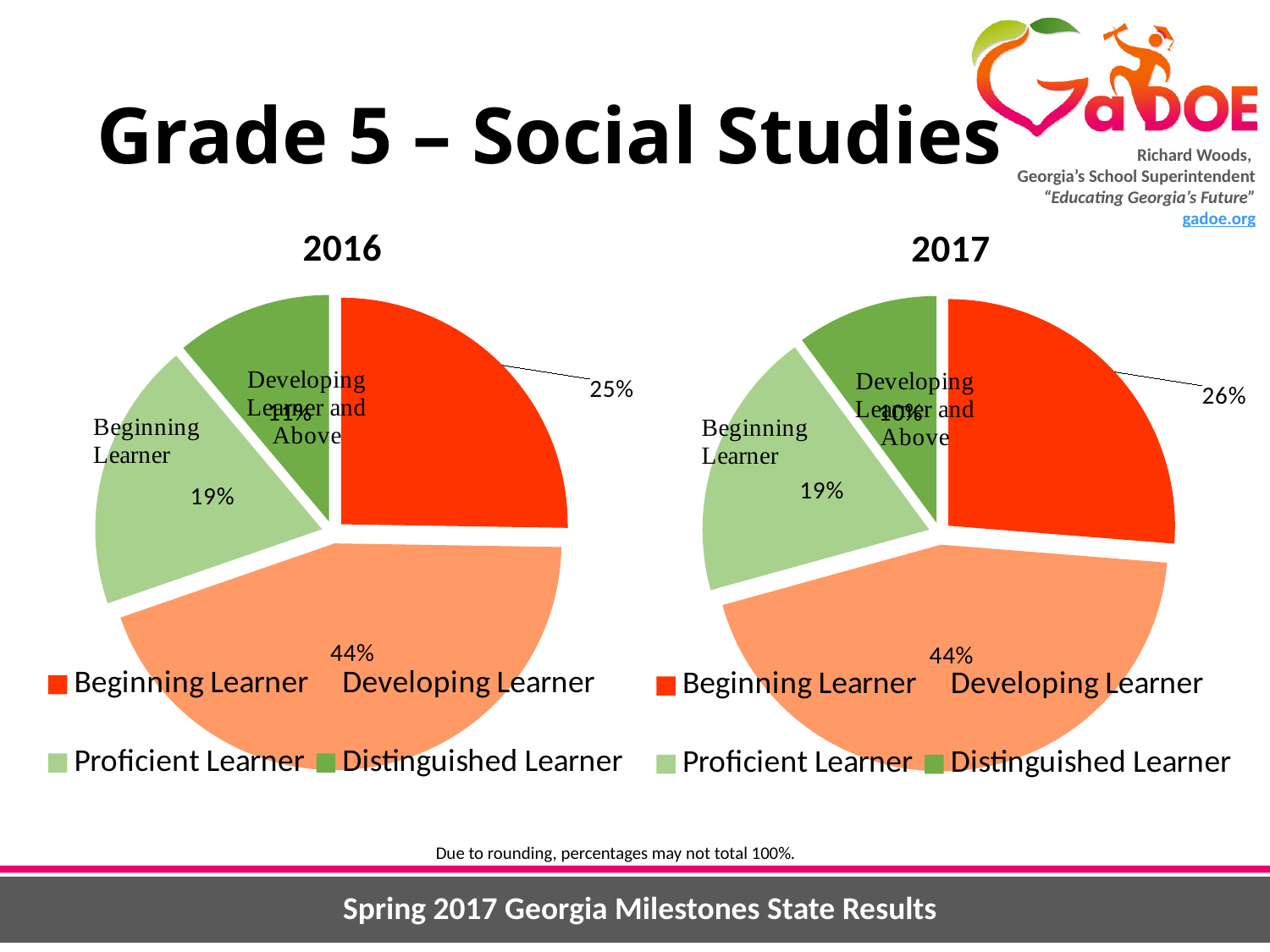
In the 2016 pie chart, what percentage is shown for Developing Learner? 44% In the 2017 pie chart, what percentage is shown for Beginning Learner? 26% How many slices does the 2017 pie chart have? 4 By how many percentage points did the Beginning Learner share change from the 2016 chart to the 2017 chart? 1 percentage point How many entries does the legend of the 2016 chart list? 4 In the 2016 pie chart, what percentage is shown for Beginning Learner? 25% In the 2016 pie chart, which category has the largest slice? Developing Learner What kind of chart is the 2016 chart? Pie chart In the 2017 pie chart, which is larger: Beginning Learner or Proficient Learner? Beginning Learner In the 2017 pie chart, which category has the smallest slice? Distinguished Learner In the 2016 pie chart, how many percentage points larger is Developing Learner than Beginning Learner? 19 percentage points In the 2017 pie chart, what percentage is shown for Proficient Learner? 19%